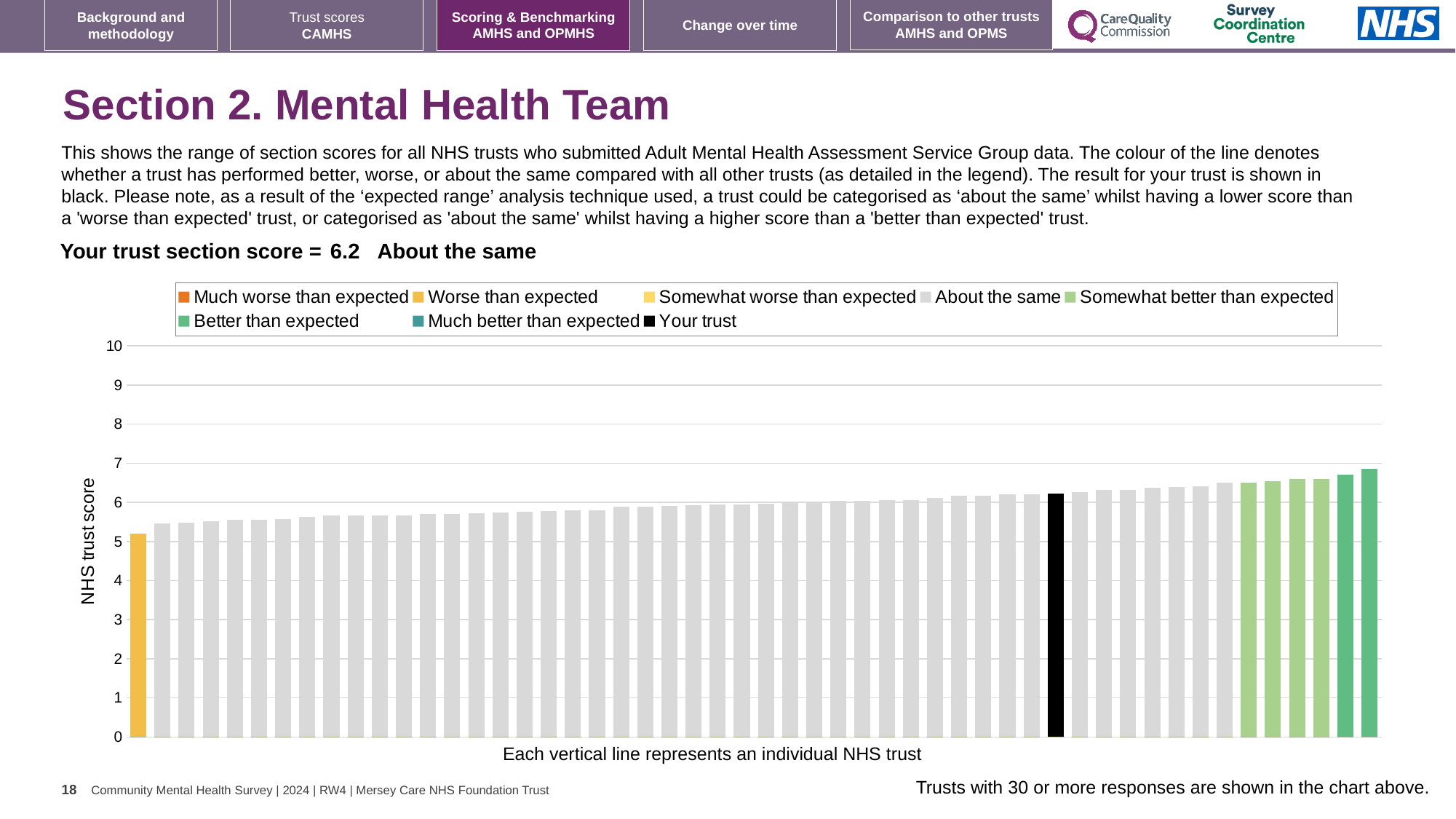
Is the value for your trust (black bar) greater or less than 5? greater What colour is the bar representing your trust? black What is the label on the vertical axis of the chart? NHS trust score Is the value of the highest (rightmost) bar greater or less than 7? less Is the value of the lowest (leftmost) bar greater or less than 6? less Which category is your trust placed in for this section? About the same What is the section score for your trust shown on the slide? 6.2 How many entries does the chart legend list? 8 Which is larger, the black bar for your trust or the leftmost bar? the black bar for your trust Which is larger, the rightmost bar or the leftmost bar? the rightmost bar Do the bar values rise or fall from left to right across the chart? rise What kind of chart is shown on the slide? bar chart